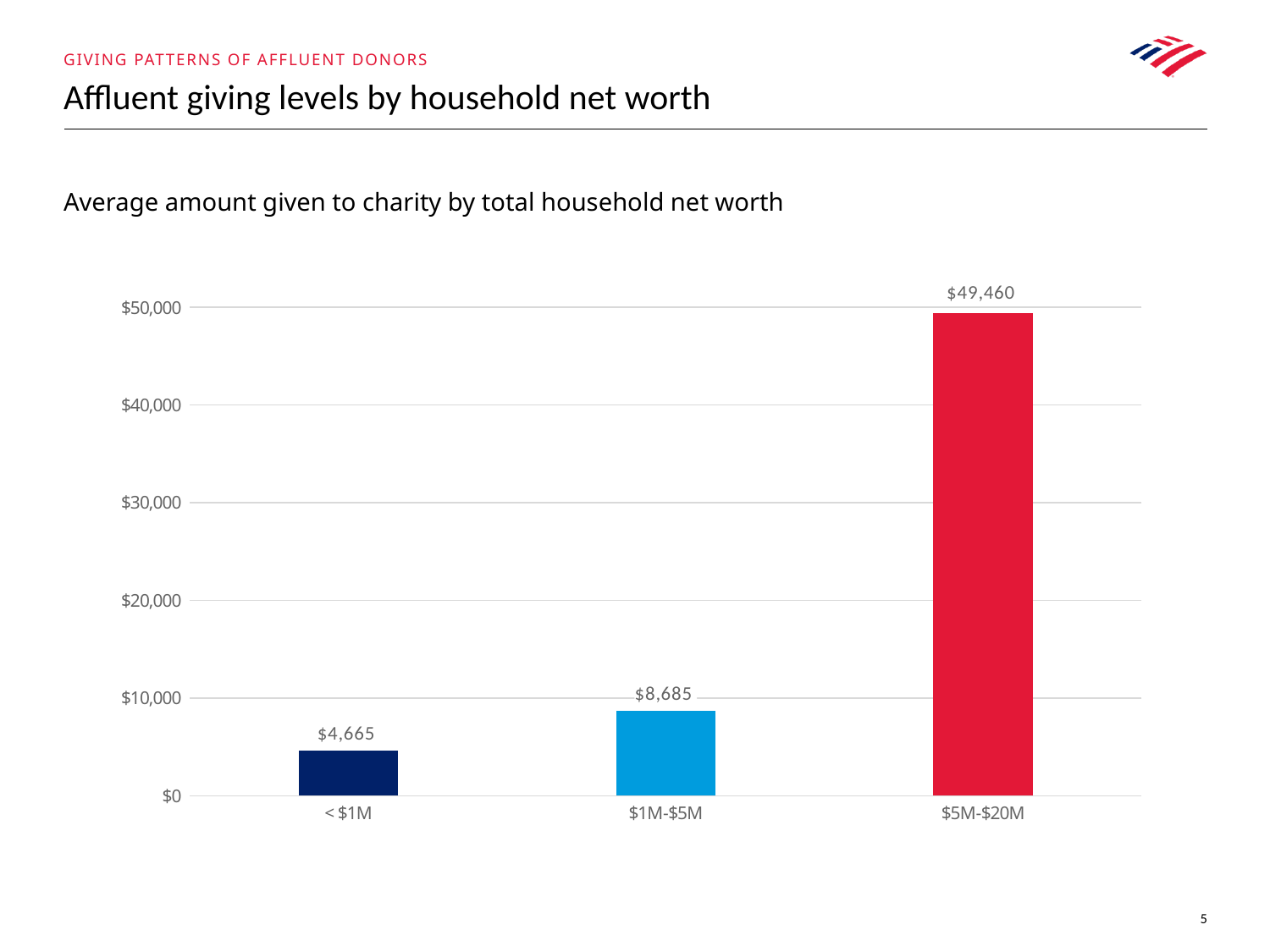
What is the average amount given to charity by households with net worth under $1M? $4,665 What is the average amount given to charity by households with net worth of $1M-$5M? $8,685 What is the difference between the average amount given by $5M-$20M households and $1M-$5M households? $40,775 How many household net worth categories are shown in the chart? 3 Which household net worth category has the lowest average amount given to charity? < $1M Is the value for $1M-$5M households greater or less than $10,000? less Do the values rise or fall as household net worth increases along the x axis? rise Which household net worth category has the highest average amount given to charity? $5M-$20M What is the average amount given to charity by households with net worth of $5M-$20M? $49,460 Which gives more on average to charity: households with net worth of $1M-$5M or households under $1M? $1M-$5M What kind of chart is shown on the slide? bar chart What is the difference between the average amount given by $1M-$5M households and households under $1M? $4,020